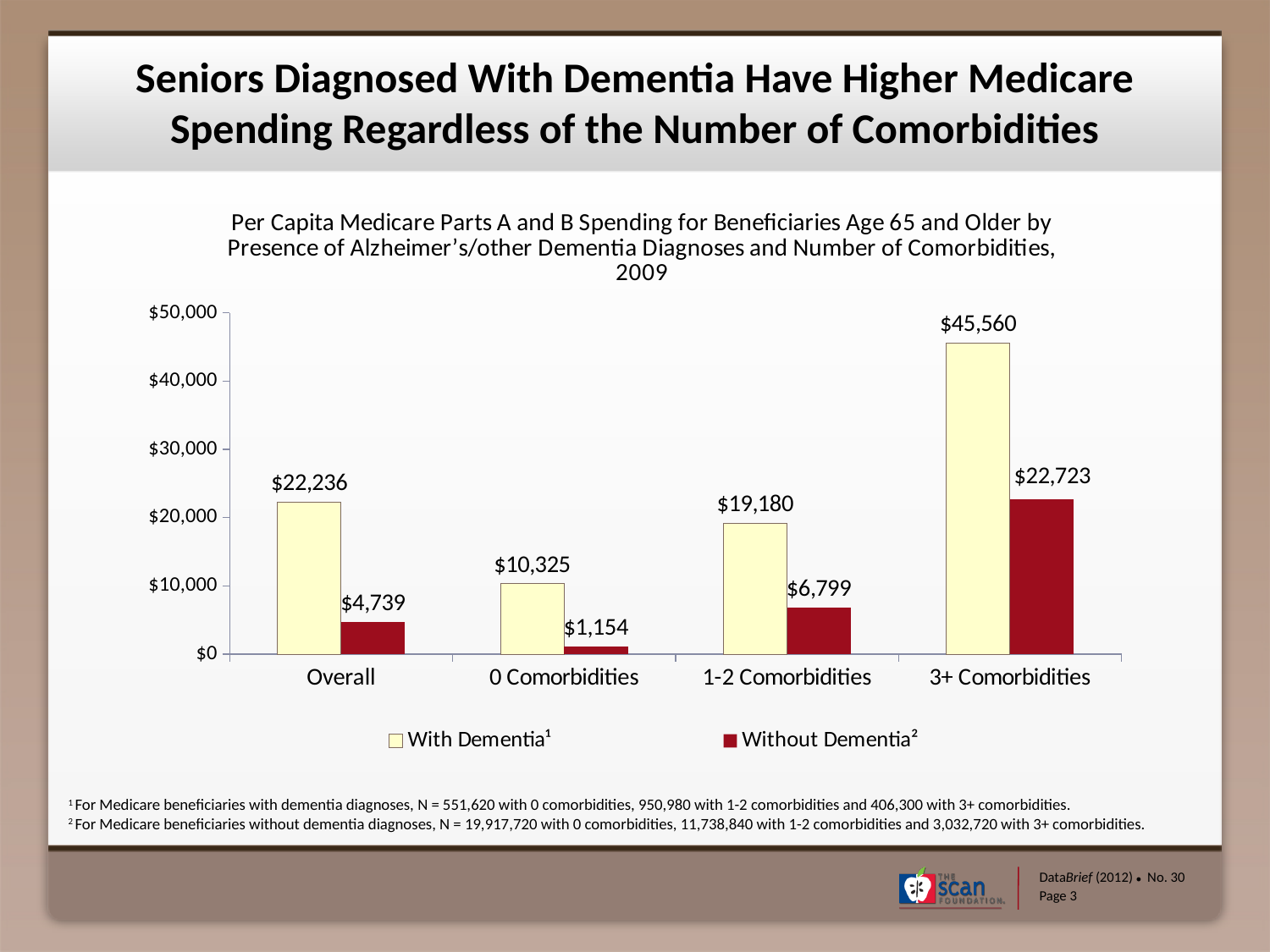
Which category has the lowest value for the Without Dementia series? 0 Comorbidities Is the With Dementia value for 3+ Comorbidities greater or less than $40,000? greater Which category has the highest value for the With Dementia series? 3+ Comorbidities Which is larger: the Without Dementia value for 3+ Comorbidities or the With Dementia value for Overall? Without Dementia value for 3+ Comorbidities What is the per capita Medicare spending for beneficiaries with dementia with 1-2 comorbidities? $19,180 What colour are the bars for the Without Dementia series? Dark red What is the per capita Medicare spending for beneficiaries without dementia with 0 comorbidities? $1,154 What is the difference between the With Dementia and Without Dementia values for 3+ Comorbidities? $22,837 What is the per capita Medicare spending for beneficiaries with dementia in the Overall category? $22,236 How many series does the legend list? 2 What kind of chart is shown on the slide? Bar chart How many categories are shown on the x axis? 4